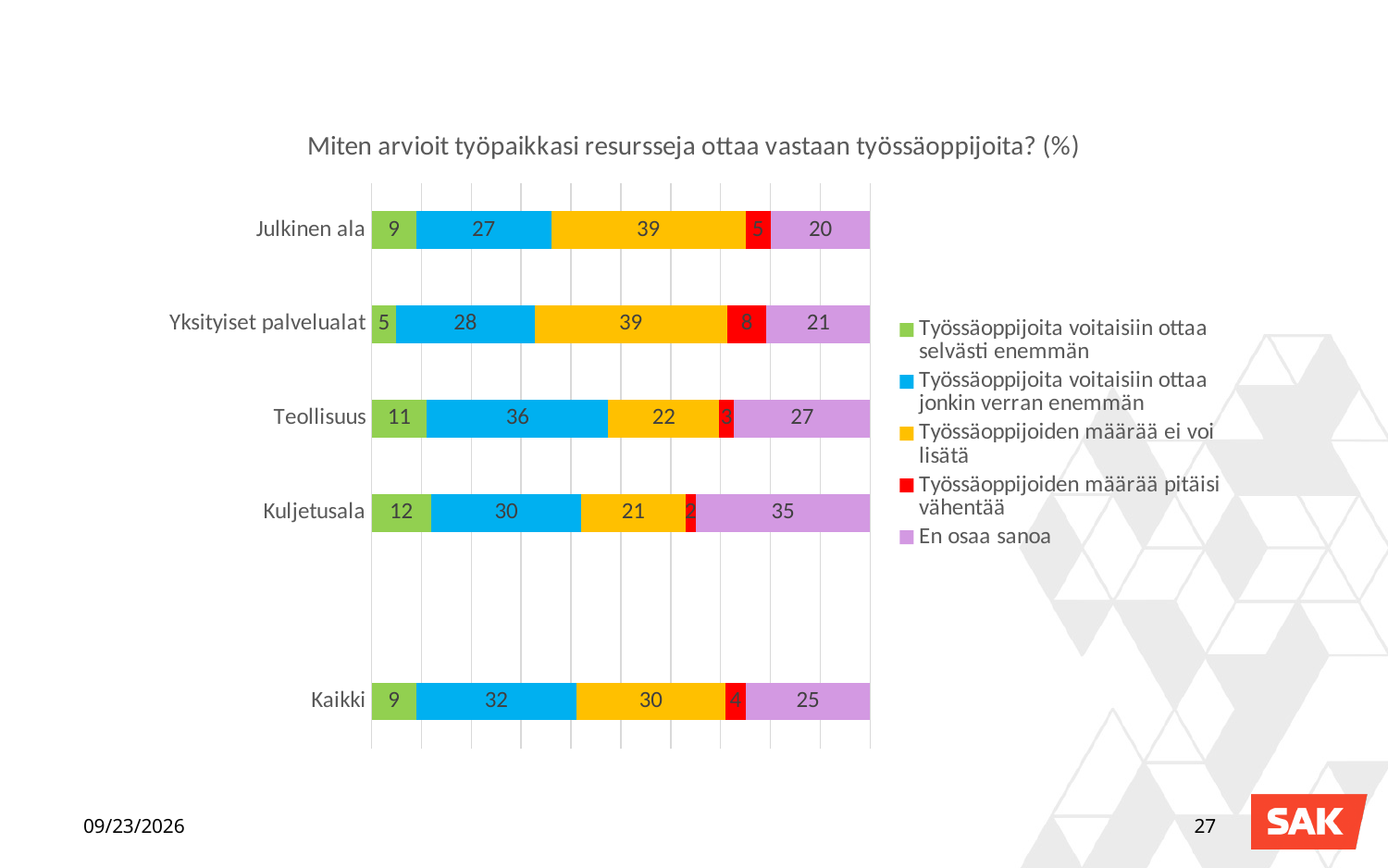
What is the difference between the 'En osaa sanoa' values for Kuljetusala and Julkinen ala? 15 What kind of chart is shown on the slide? Stacked bar chart What is the value of 'Työssäoppijoiden määrää pitäisi vähentää' for Kaikki? 4 Which is larger: the 'Työssäoppijoiden määrää ei voi lisätä' value for Teollisuus or for Kaikki? Kaikki What is the total of the stacked bar for Yksityiset palvelualat? 101 Which category has the lowest value for 'Työssäoppijoiden määrää pitäisi vähentää'? Kuljetusala How many categories are shown on the vertical axis? 5 How many series does the legend list? 5 What is the value of 'Työssäoppijoita voitaisiin ottaa jonkin verran enemmän' for Teollisuus? 36 What is the value of 'En osaa sanoa' for Kuljetusala? 35 What is the value of 'Työssäoppijoiden määrää ei voi lisätä' for Julkinen ala? 39 Which category has the highest value for 'Työssäoppijoita voitaisiin ottaa selvästi enemmän'? Kuljetusala